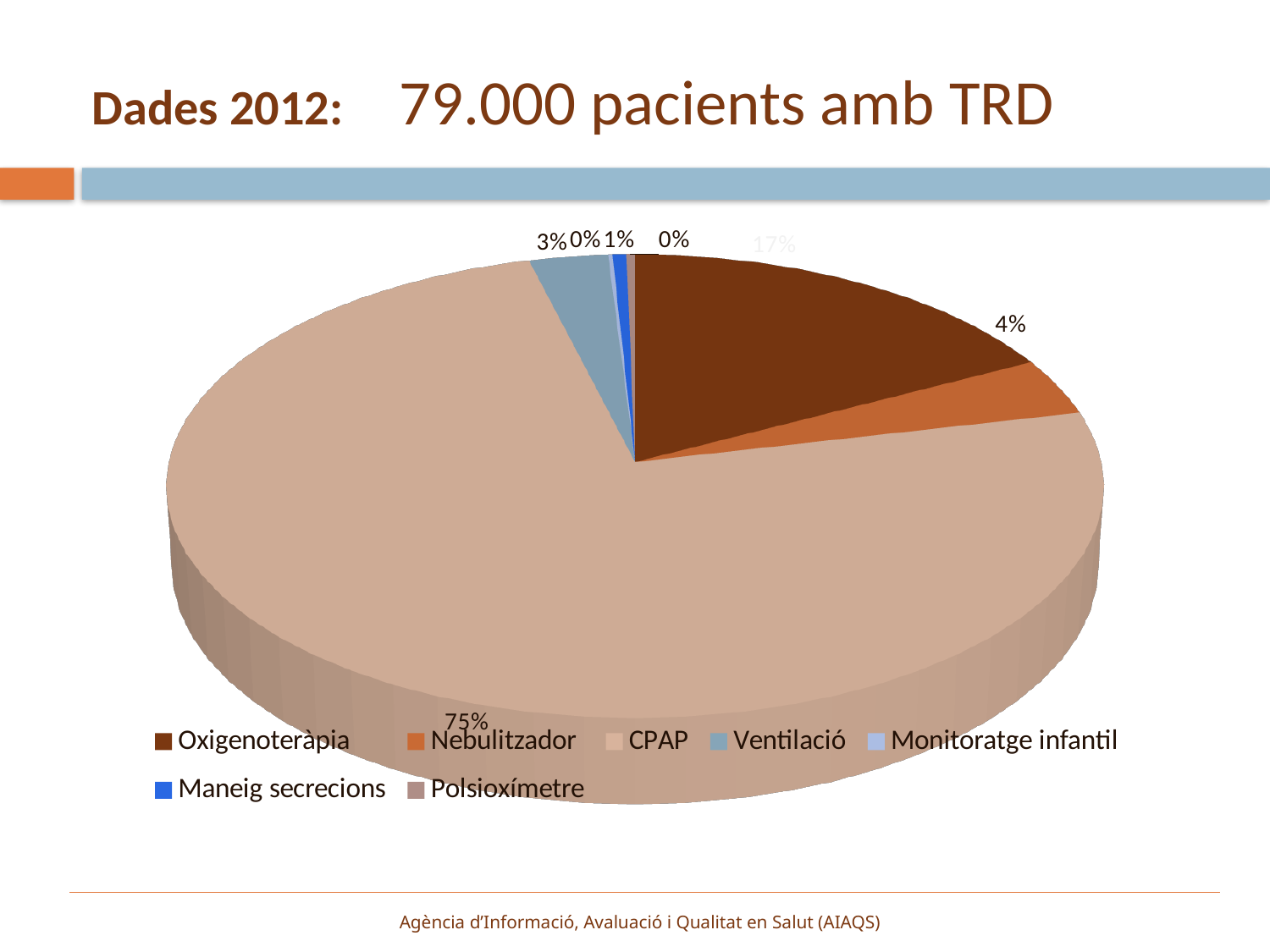
What share of the pie does CPAP represent? 75% What share of the pie does Ventilació represent? 3% Which is larger, the slice for Oxigenoteràpia or the slice for Nebulitzador? Oxigenoteràpia Which category has the largest slice of the pie? CPAP According to the slide title, how many patients with TRD were there in 2012? 79.000 What is the difference in percentage points between the CPAP slice and the Oxigenoteràpia slice? 58 Which legend entry is shown in dark brown? Oxigenoteràpia What share of the pie does Nebulitzador represent? 4% How many categories does the legend of the pie chart list? 7 What kind of chart is shown on the slide? pie chart